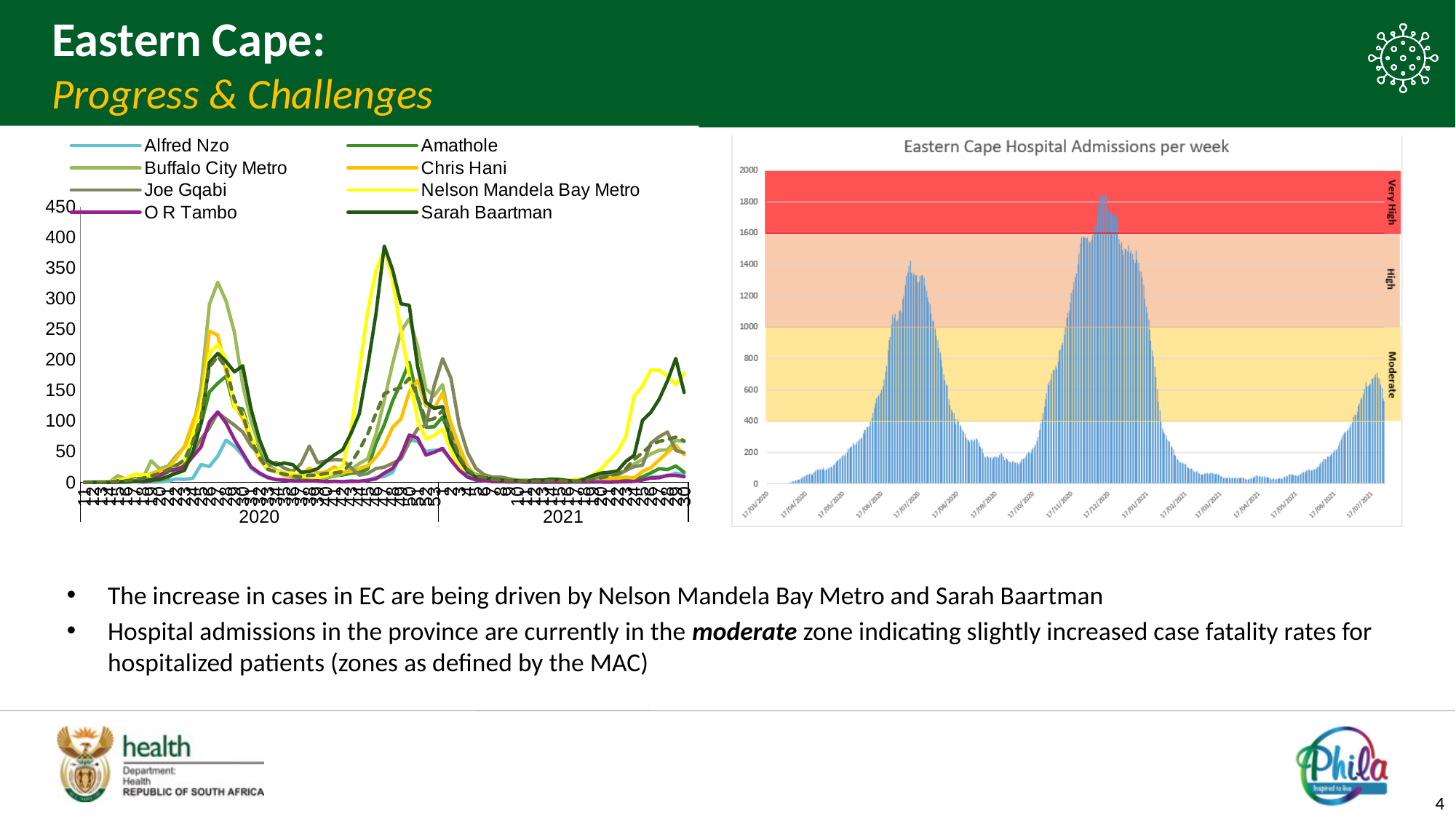
In the left chart, which series reaches the highest peak value? Sarah Baartman How many series does the legend of the left chart list? 8 What is the title of the chart on the right of the slide? Eastern Cape Hospital Admissions per week In the 'Eastern Cape Hospital Admissions per week' chart, is the highest weekly admissions value greater or less than 1600? greater In the left chart, is the peak value for Buffalo City Metro in 2020 greater or less than 300? greater In the 'Eastern Cape Hospital Admissions per week' chart, is the peak of the first wave in mid-2020 greater or less than 1000? greater What kind of chart is the chart on the left of the slide? line chart In the left chart, which series has the higher peak in the first 2020 wave: Buffalo City Metro or O R Tambo? Buffalo City Metro What kind of chart is the 'Eastern Cape Hospital Admissions per week' chart? bar chart In the 'Eastern Cape Hospital Admissions per week' chart, what is the maximum value shown on the y axis? 2000